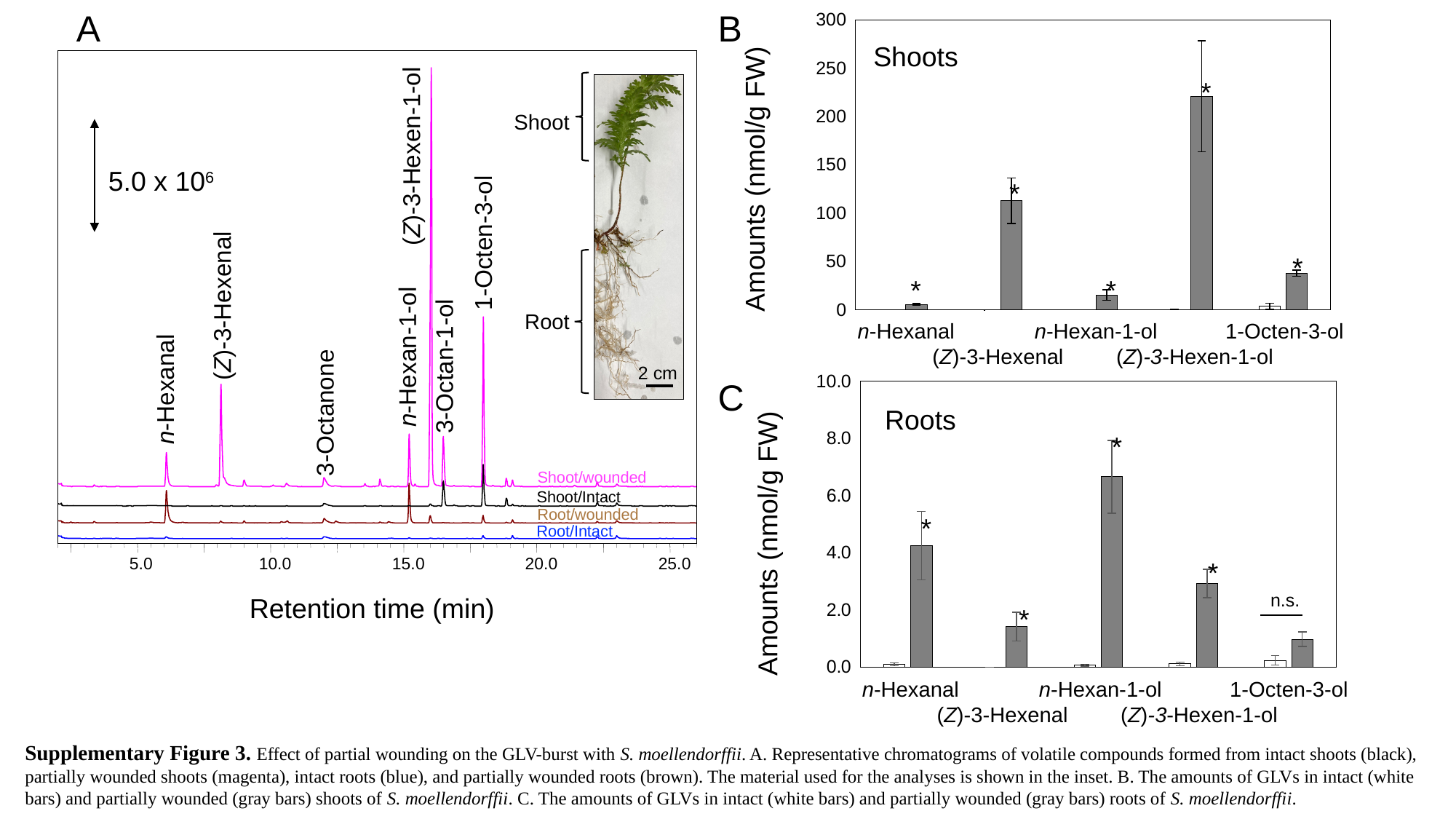
In panel C (Roots), which compound is marked 'n.s.' instead of an asterisk? 1-Octen-3-ol In panel C (Roots), which compound has the tallest gray (wounded) bar? n-Hexan-1-ol In panel B (Shoots), is the gray bar for (Z)-3-Hexenal greater or less than 50? greater How many chromatogram traces are shown in panel A? 4 What kind of chart is panel B (Shoots)? bar chart How many compound categories are shown on the x axis of panel B (Shoots)? 5 In panel C (Roots), is the gray bar for n-Hexan-1-ol greater or less than 6.0? greater In panel C (Roots), is the gray bar for 1-Octen-3-ol greater or less than 2.0? less In panel A, which sample does the magenta trace represent? Shoot/wounded In panel C (Roots), which gray bar is taller: n-Hexanal or (Z)-3-Hexenal? n-Hexanal In panel B (Shoots), which compound has the tallest gray (wounded) bar? (Z)-3-Hexen-1-ol